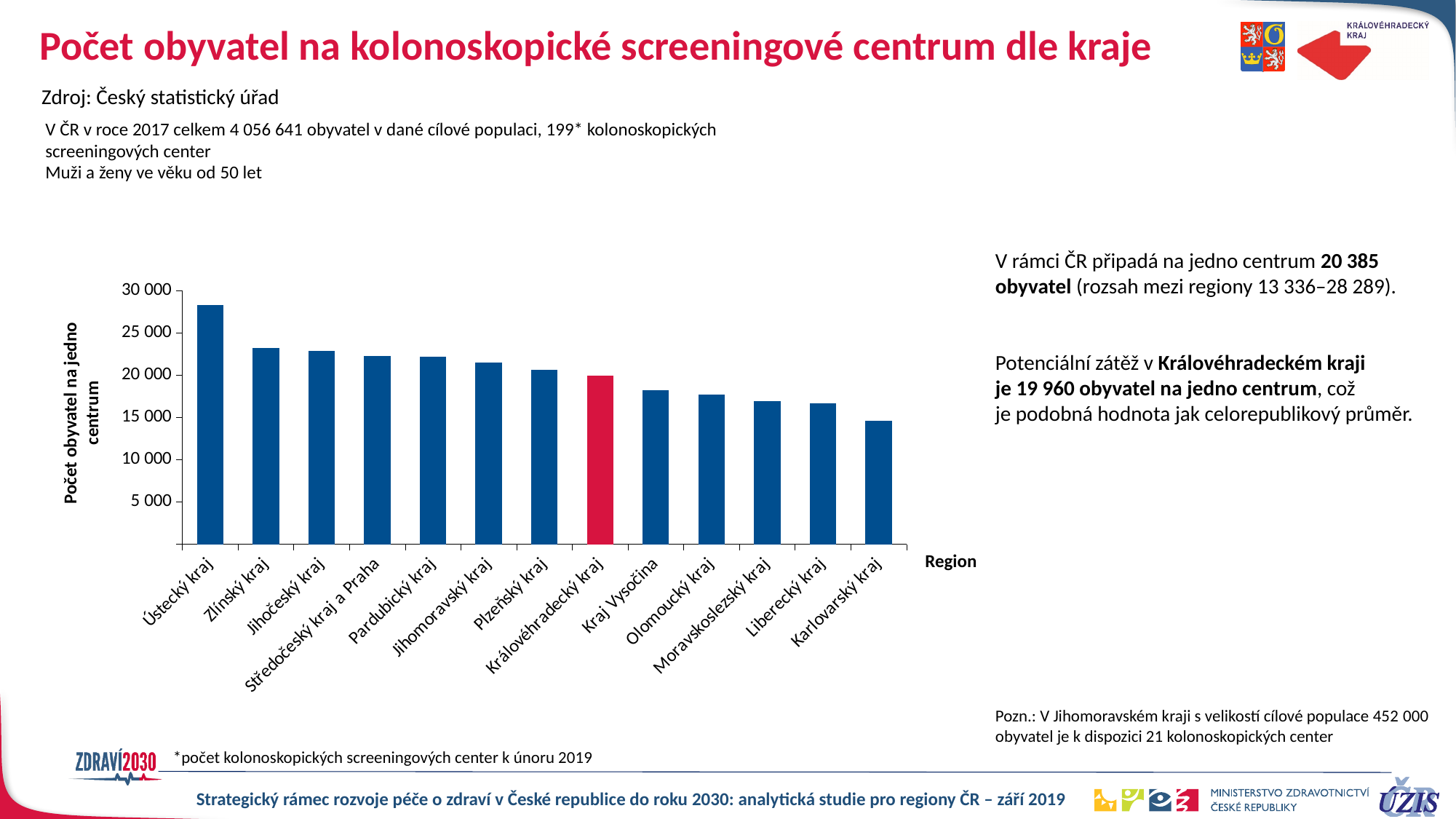
According to the slide, how many inhabitants per centre does Královéhradecký kraj have? 19 960 Is the value for Zlínský kraj greater or less than 20 000? greater Is the value for Liberecký kraj greater or less than 15 000? greater Is the value for Kraj Vysočina greater or less than 20 000? less Which region's bar is highlighted in red? Královéhradecký kraj How many regions (kraje) are plotted on the x axis of the chart? 13 Do the values rise or fall moving from left to right along the x axis? fall Which region has the highest number of inhabitants per colonoscopy screening centre? Ústecký kraj Which region has the lowest number of inhabitants per colonoscopy screening centre? Karlovarský kraj Which has a higher value, Plzeňský kraj or Olomoucký kraj? Plzeňský kraj What kind of chart is shown on the slide? bar chart